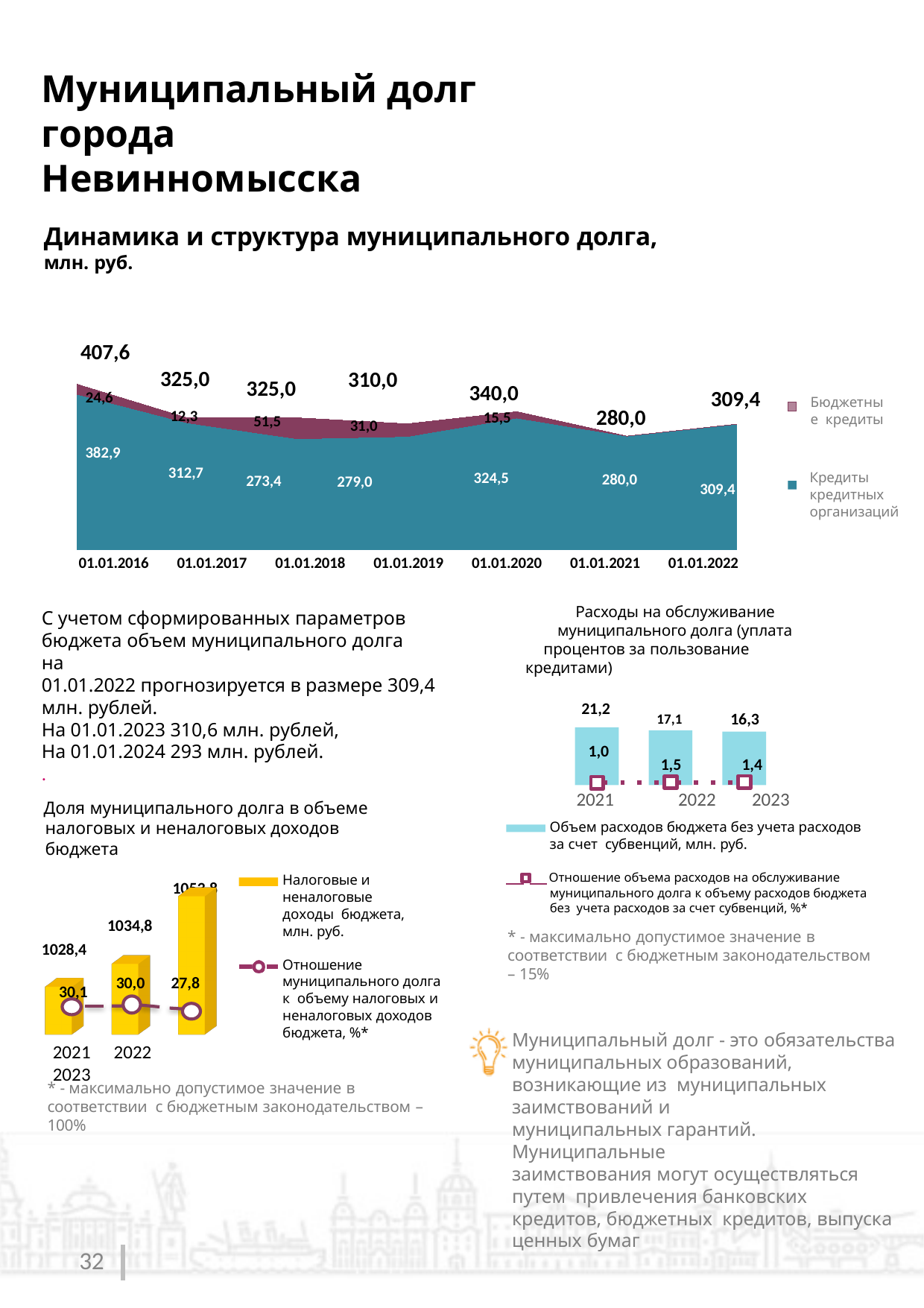
In the top chart 'Динамика и структура муниципального долга', on which date is the total municipal debt highest? 01.01.2016 In the bottom-right chart 'Расходы на обслуживание муниципального долга', what is the ratio of debt servicing expenditures to budget expenditures for 2022? 1,5 In the bottom-right chart 'Расходы на обслуживание муниципального долга', which year has the highest volume of budget expenditures? 2021 In the top chart 'Динамика и структура муниципального долга', by how much does the total debt on 01.01.2016 exceed the total on 01.01.2017? 82,6 In the top chart 'Динамика и структура муниципального долга', how many series does the legend list? 2 In the top chart 'Динамика и структура муниципального долга', on which date is the total municipal debt lowest? 01.01.2021 What kind of chart is the top chart 'Динамика и структура муниципального долга'? Area chart In the bottom-left chart 'Доля муниципального долга в объеме налоговых и неналоговых доходов бюджета', which year has larger tax and non-tax revenues, 2021 or 2022? 2022 In the top chart 'Динамика и структура муниципального долга', what is the value of 'Бюджетные кредиты' on 01.01.2018? 51,5 In the bottom-left chart 'Доля муниципального долга в объеме налоговых и неналоговых доходов бюджета', what is the ratio of municipal debt to tax and non-tax revenues for 2023? 27,8 In the top chart 'Динамика и структура муниципального долга', how many dates are shown on the x axis? 7 In the top chart 'Динамика и структура муниципального долга', what is the value of 'Кредиты кредитных организаций' on 01.01.2016? 382,9